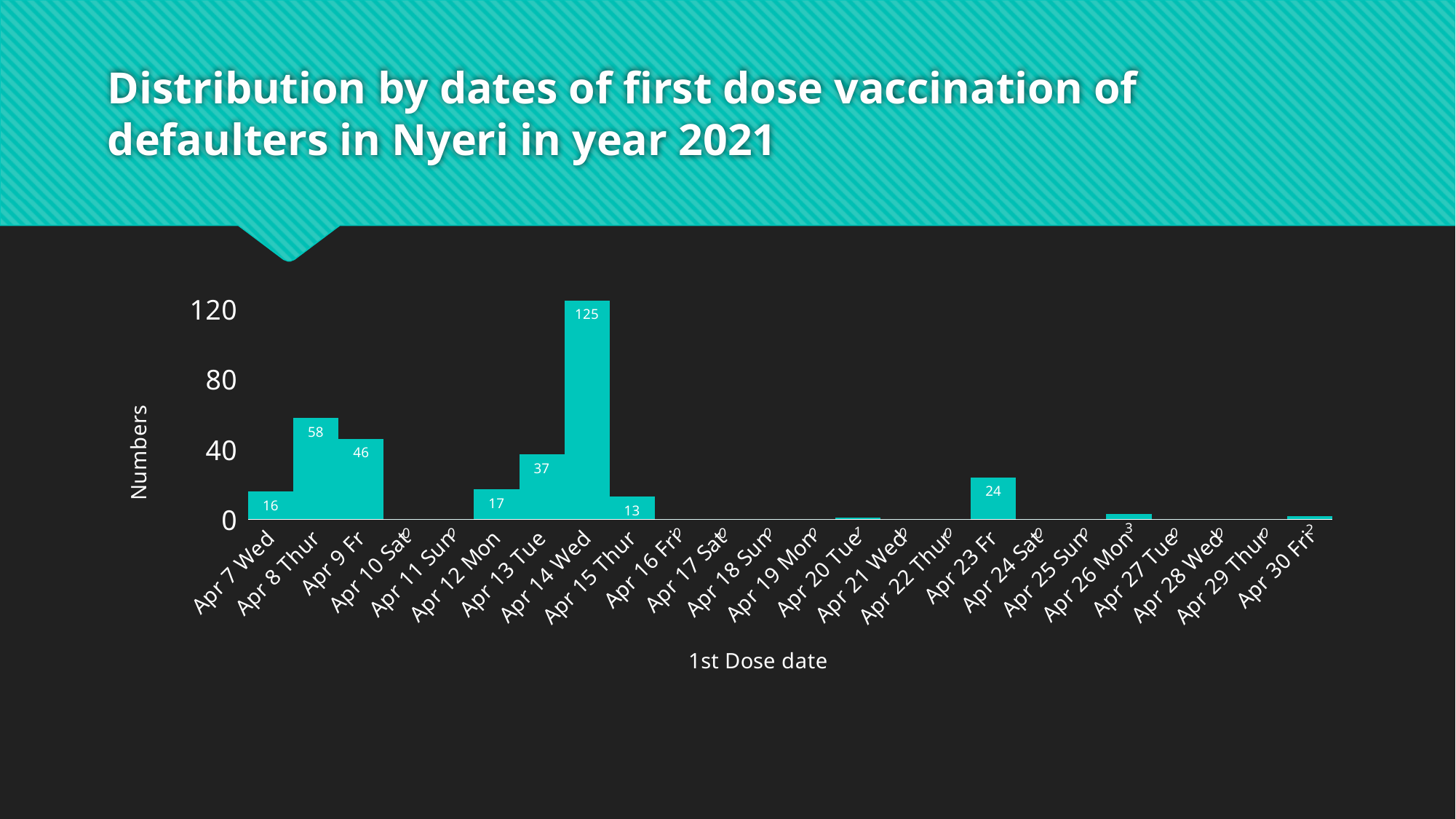
What is the title of the vertical axis? Numbers What is the value for Apr 14 Wed? 125 Which is larger, the value for Apr 9 Fr or the value for Apr 13 Tue? Apr 9 Fr What is the value for Apr 23 Fr? 24 Is the value for Apr 14 Wed greater or less than 80? greater What kind of chart is shown on the slide? bar chart How many dates are shown on the x axis? 24 What is the difference between the values for Apr 8 Thur and Apr 9 Fr? 12 Which date has the highest number of defaulters? Apr 14 Wed What is the difference between the values for Apr 14 Wed and Apr 13 Tue? 88 What is the value for Apr 15 Thur? 13 What is the value for Apr 8 Thur? 58